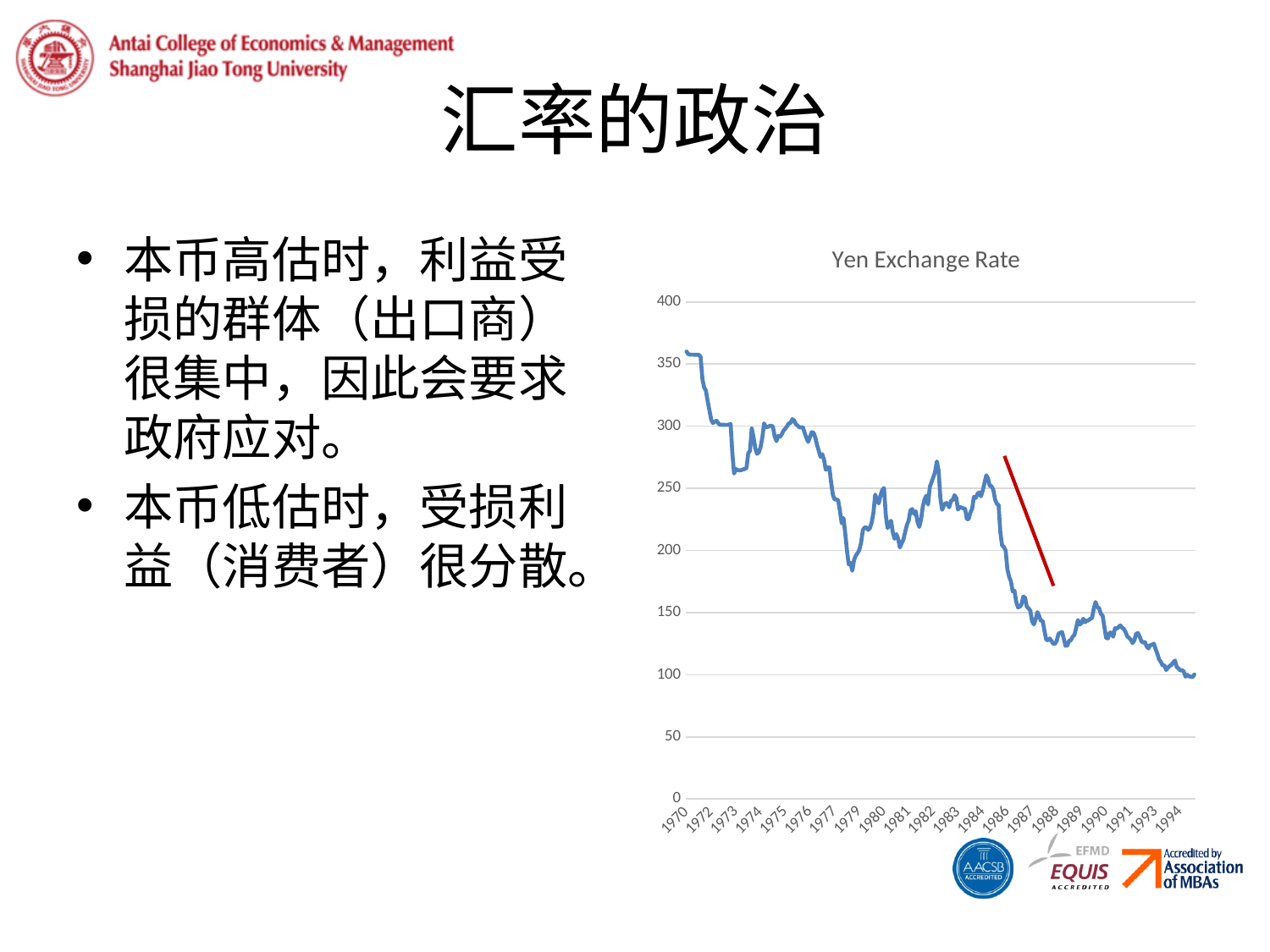
Is the Yen Exchange Rate at the start of 1970 greater or less than 300? greater Which year has the higher Yen Exchange Rate, 1970 or 1994? 1970 Is the Yen Exchange Rate at the end of 1994 greater or less than 150? less Is the Yen Exchange Rate in 1987 greater or less than 200? less What type of chart is shown on the slide? line chart What is the highest value shown on the vertical axis of the chart? 400 What is the title of the chart? Yen Exchange Rate Which year has the higher Yen Exchange Rate, 1980 or 1990? 1980 Does the Yen Exchange Rate generally rise or fall from 1970 to 1994? fall